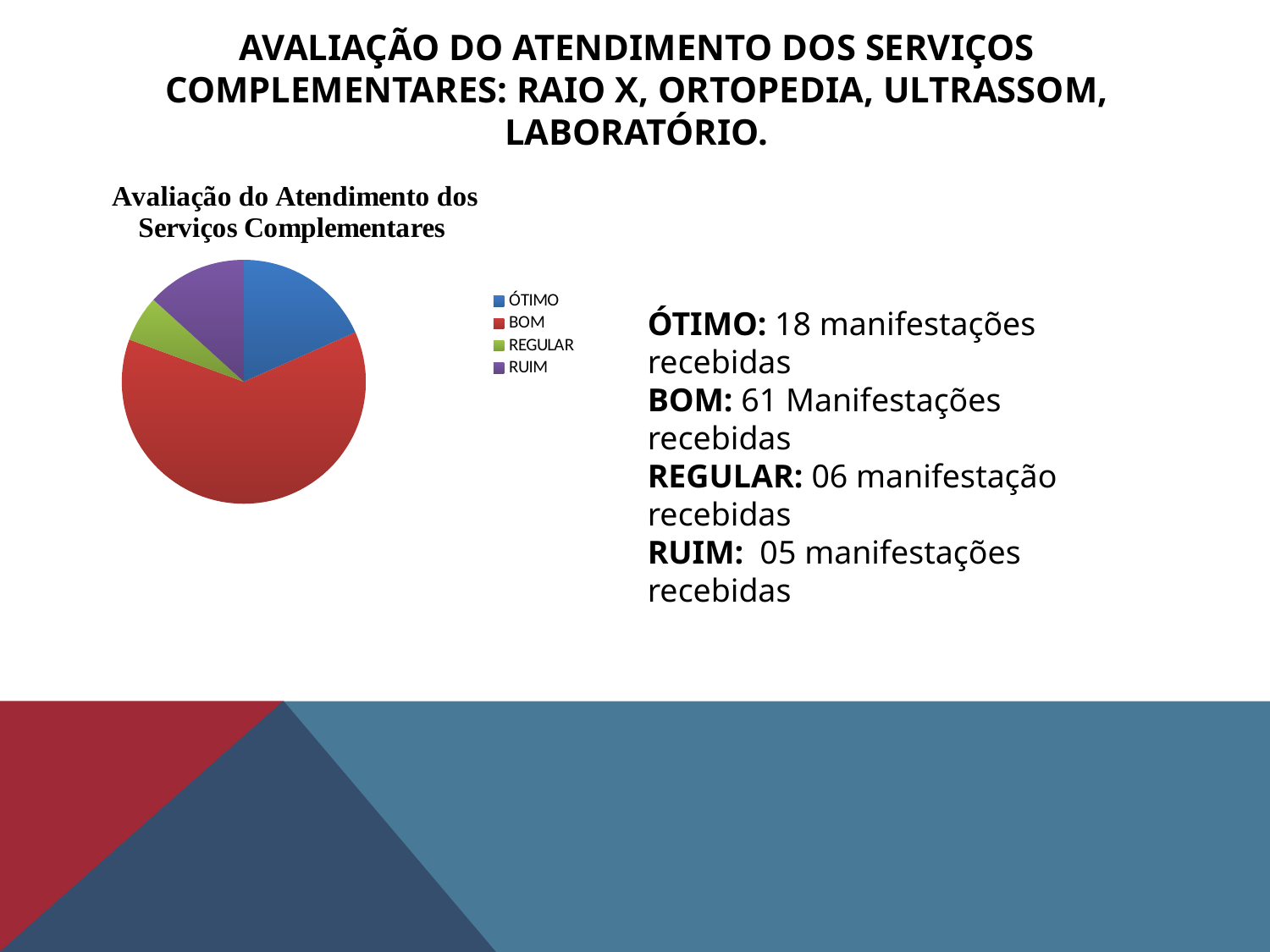
How many categories does the pie chart's legend list? 4 Which colour represents BOM in the pie chart? red What is the difference between the number of manifestações for BOM and for ÓTIMO? 43 What is the total number of manifestações across all four categories? 90 How many manifestações were received for REGULAR? 06 What kind of chart is shown on the slide? pie chart How many manifestações were received for BOM? 61 Which category has the largest slice of the pie chart? BOM How many manifestações were received for ÓTIMO? 18 What is the title of the pie chart? Avaliação do Atendimento dos Serviços Complementares How many manifestações were received for RUIM? 05 Which is larger, the slice for ÓTIMO or the slice for BOM? BOM